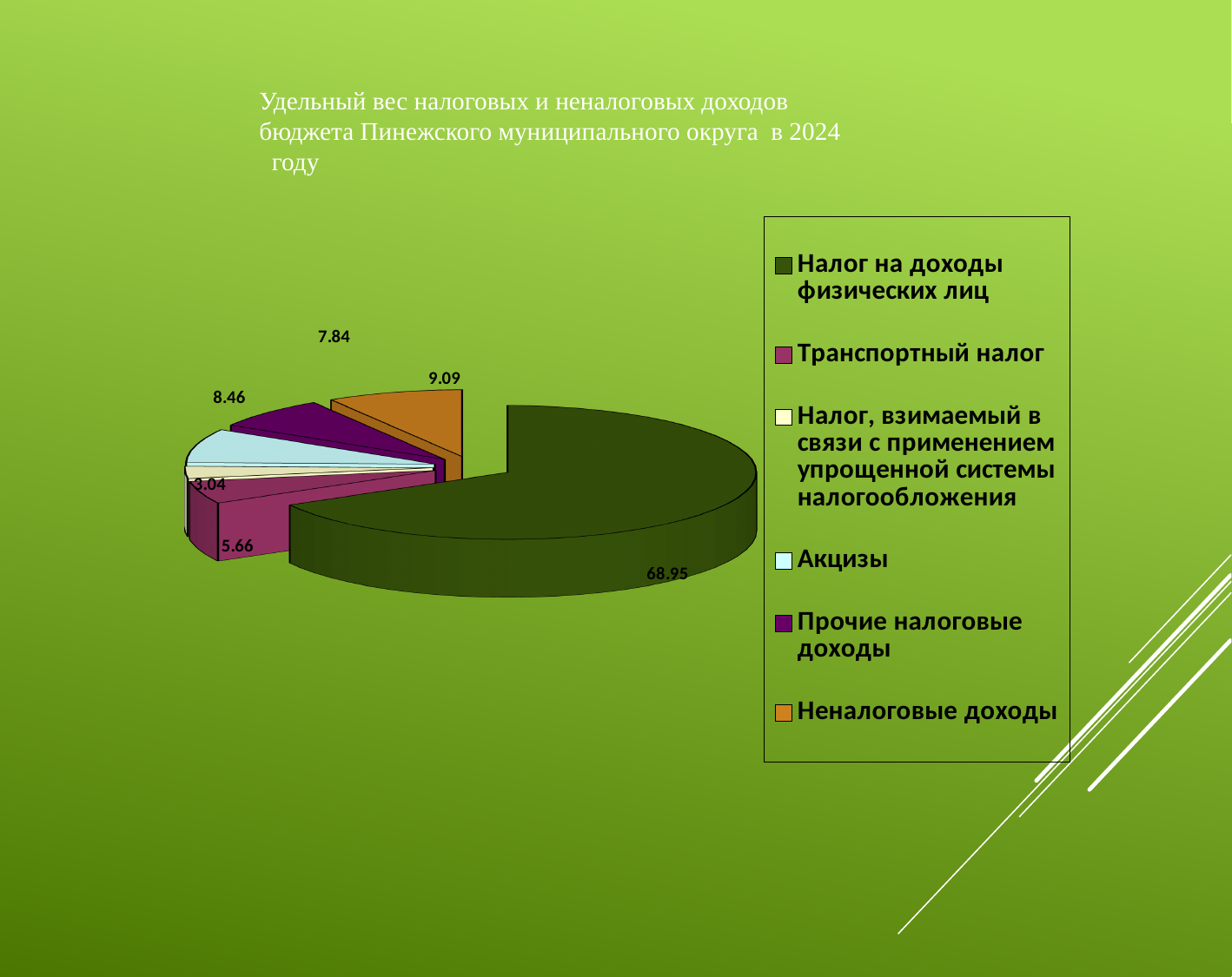
Which category has the largest slice of the pie? Налог на доходы физических лиц How many categories does the legend list? 6 What is the value for Неналоговые доходы? 9.09 What colour is the slice for Неналоговые доходы? orange Which is larger, the value for Акцизы or the value for Прочие налоговые доходы? Акцизы Which category has the smallest slice of the pie? Налог, взимаемый в связи с применением упрощенной системы налогообложения What is the value for Прочие налоговые доходы? 7.84 What is the value for Акцизы? 8.46 What is the value for Транспортный налог? 5.66 What is the difference between the values for Неналоговые доходы and Транспортный налог? 3.43 What is the value for Налог на доходы физических лиц? 68.95 What type of chart is shown on the slide? pie chart